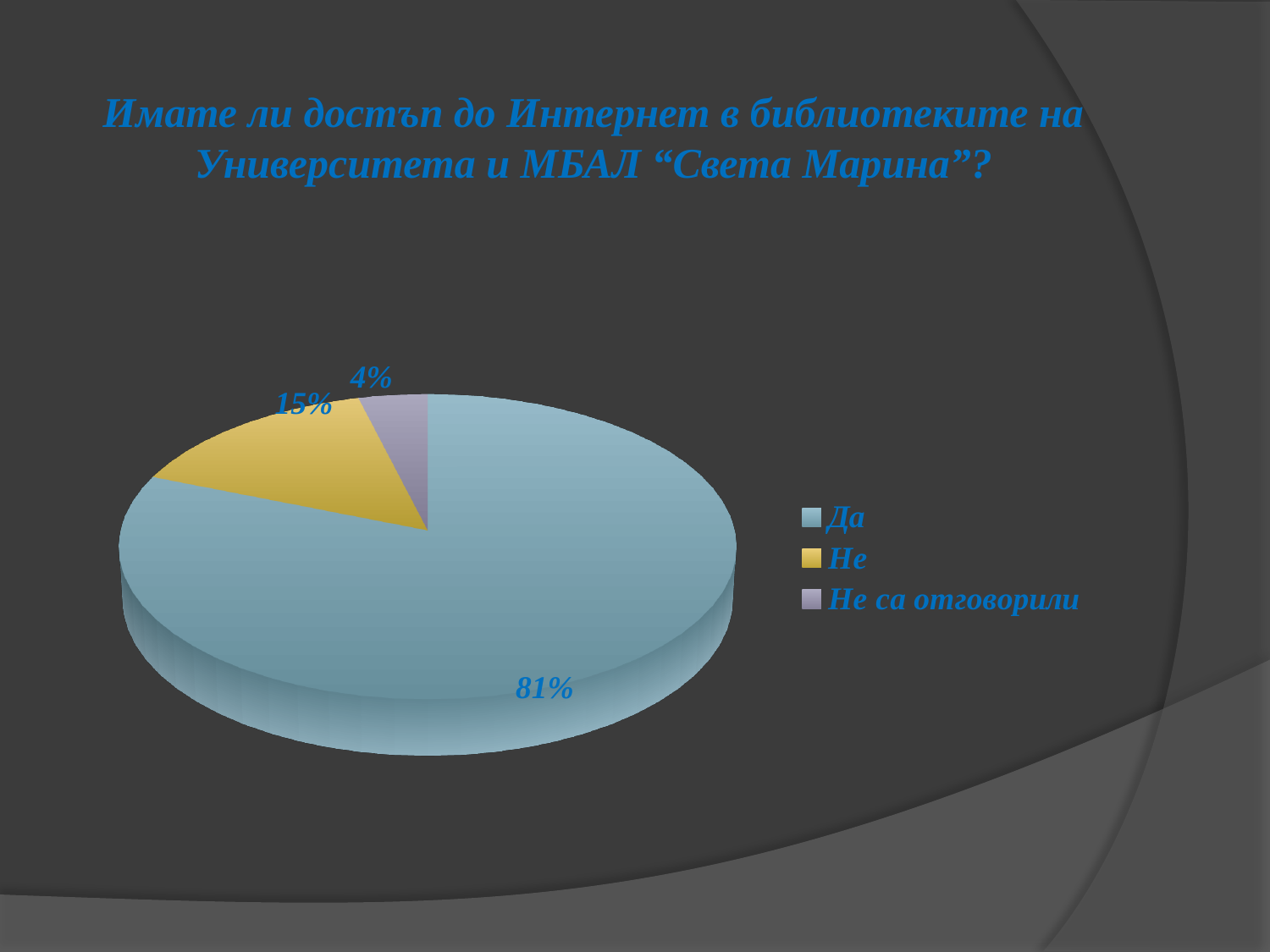
What kind of chart is shown on the slide? Pie chart What is the difference in percentage points between "Да" and "Не"? 66 Which category has the smallest slice of the pie? Не са отговорили How many categories does the pie chart show? 3 What is the difference in percentage points between "Не" and "Не са отговорили"? 11 What is the title of the chart on the slide? Имате ли достъп до Интернет в библиотеките на Университета и МБАЛ "Света Марина"? What share of the pie does "Не са отговорили" represent? 4% What share of the pie does "Да" represent? 81% What share of the pie does "Не" represent? 15% What colour is the slice for "Не"? Yellow Which is larger, the slice for "Не" or the slice for "Не са отговорили"? Не Which category has the largest slice of the pie? Да